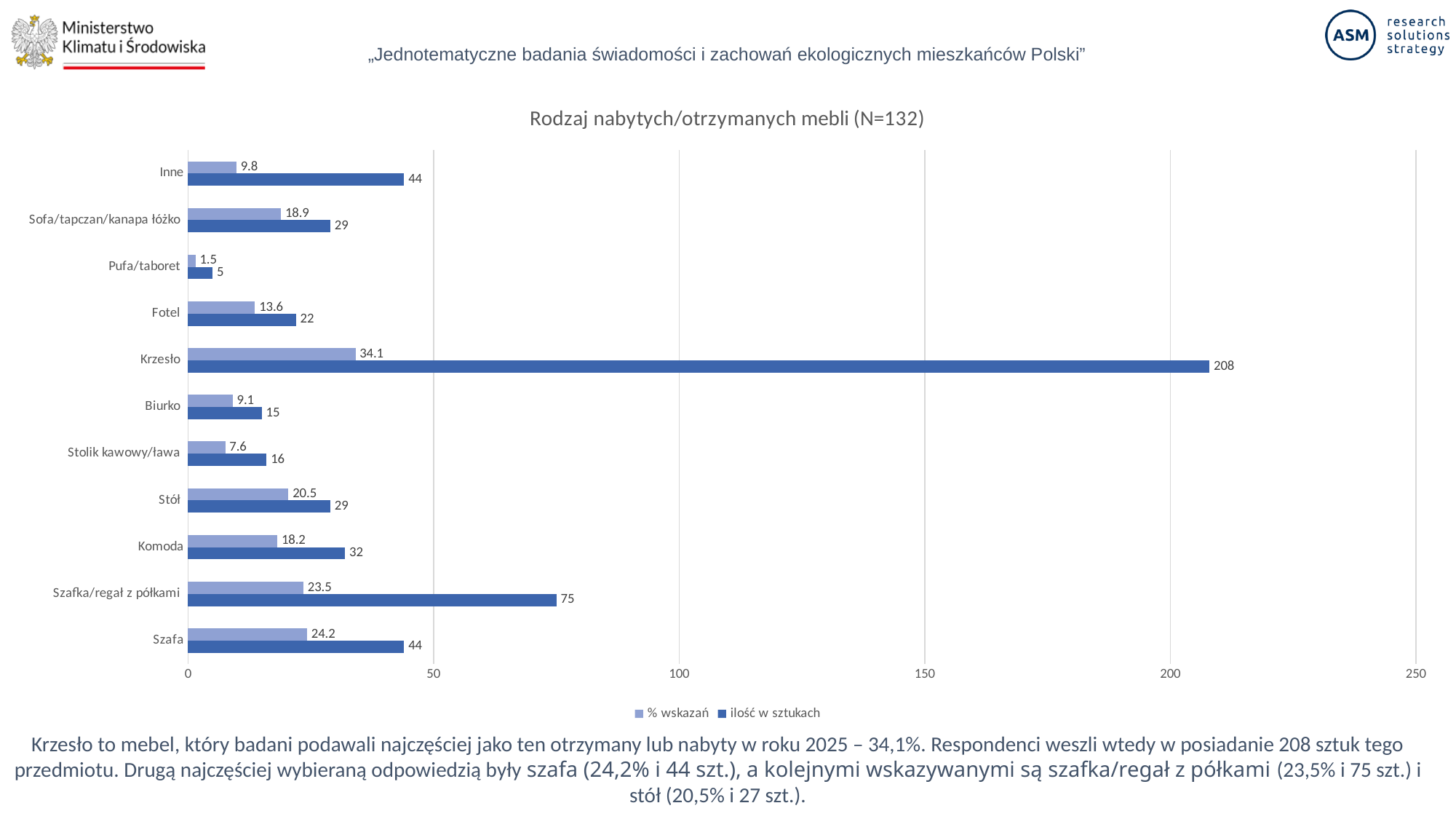
Is the "ilość w sztukach" value for Krzesło greater or less than 200? greater What kind of chart is shown on the slide? Bar chart How many series does the legend list? 2 Which has a larger "% wskazań" value, Stół or Komoda? Stół What is the "% wskazań" value for Szafa? 24.2 What is the "ilość w sztukach" value for Szafka/regał z półkami? 75 What is the "% wskazań" value for Pufa/taboret? 1.5 What is the "ilość w sztukach" value for Krzesło? 208 What is the difference between the "ilość w sztukach" values for Krzesło and Szafka/regał z półkami? 133 Which category has the highest "ilość w sztukach" value? Krzesło Which category has the lowest "% wskazań" value? Pufa/taboret How many categories are shown on the chart? 11